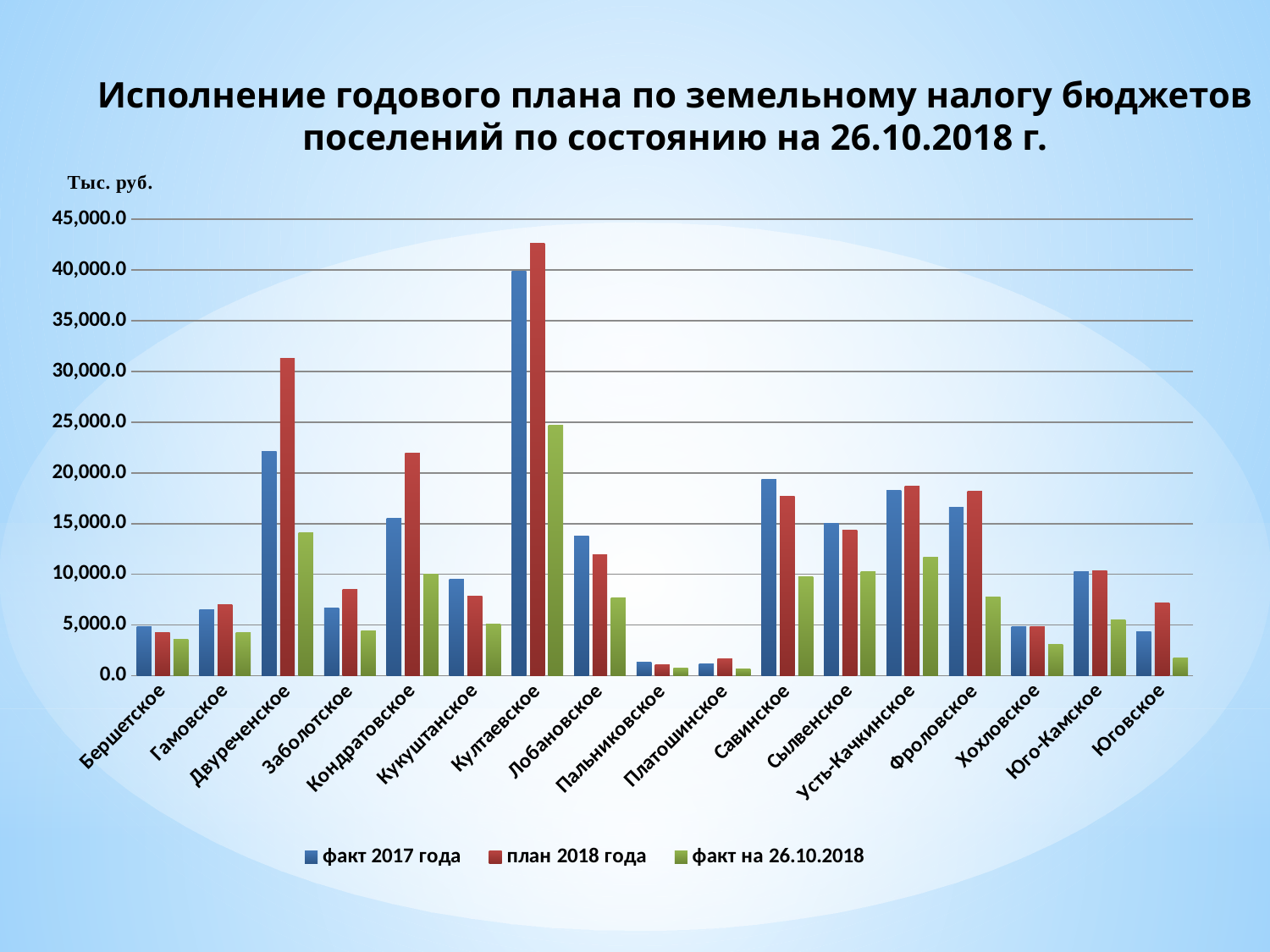
For Савинское, which is larger: факт 2017 года or план 2018 года? факт 2017 года Is the факт на 26.10.2018 value for Двуреченское greater or less than 15,000.0? less How many series does the legend list? 3 Which settlement has the highest value for план 2018 года? Култаевское Which settlement has the lowest value for план 2018 года? Пальниковское Is the факт 2017 года value for Савинское greater or less than 20,000.0? less Is the план 2018 года value for Култаевское greater or less than 40,000.0? greater For Юговское, which is larger: факт 2017 года or план 2018 года? план 2018 года What kind of chart is shown on the slide? bar chart How many settlements (categories) are shown on the x axis? 17 What unit is indicated above the vertical axis? Тыс. руб.